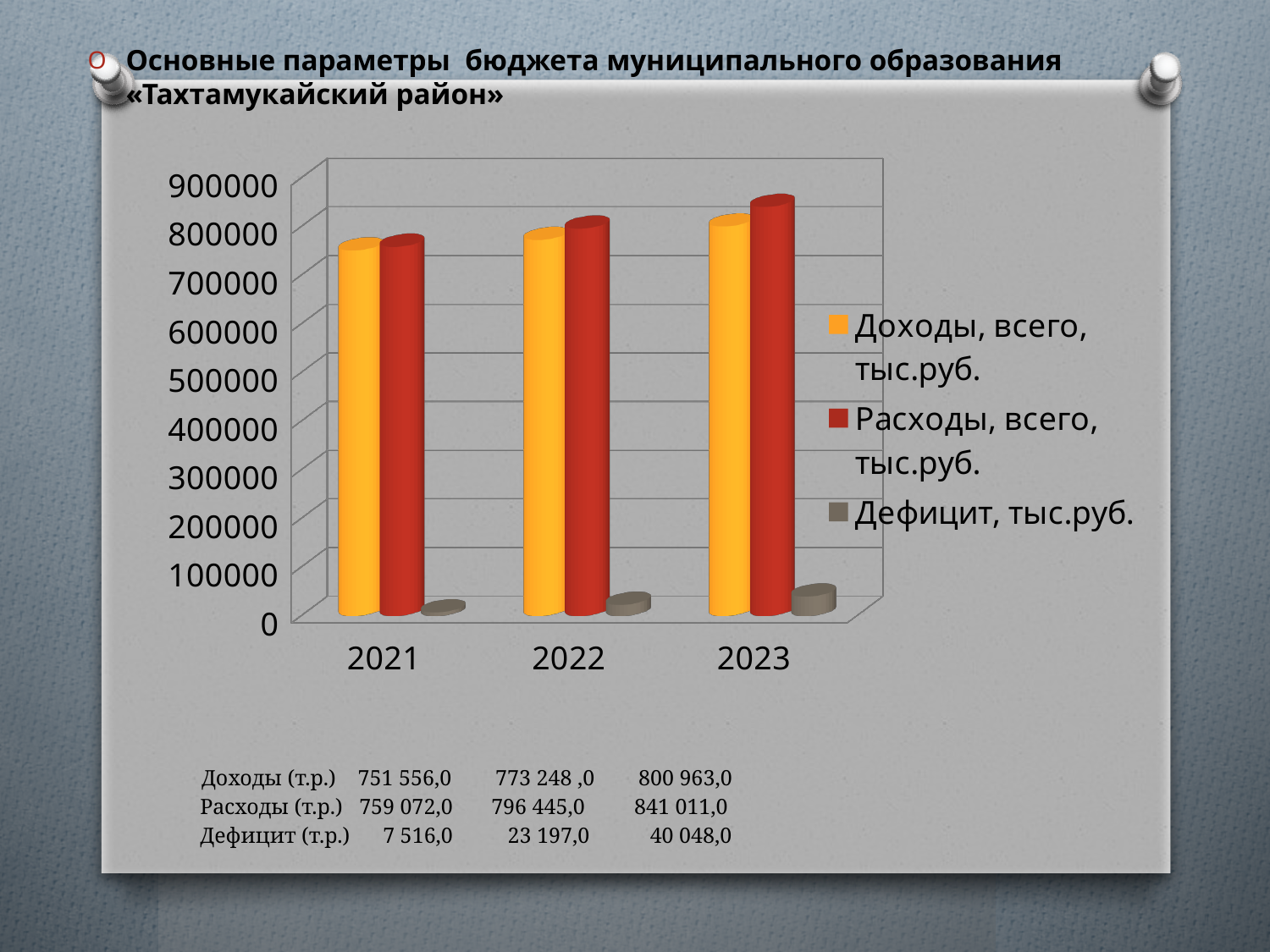
Is the Доходы, всего bar for 2023 greater or less than 700000? greater What kind of chart is shown on the slide? bar chart According to the figures printed below the chart, what is the value of Доходы (т.р.) for 2021? 751 556,0 Which colour represents Дефицит, тыс.руб. in the chart legend? grey According to the figures printed below the chart, what is the value of Расходы (т.р.) for 2023? 841 011,0 Is the Дефицит bar for 2023 greater or less than 100000? less How many years are shown on the x axis of the chart? 3 In which year is the Дефицит bar the lowest? 2021 How many series does the chart legend list? 3 Do the Расходы, всего values rise or fall from 2021 to 2023? rise According to the figures printed below the chart, what is the value of Дефицит (т.р.) for 2022? 23 197,0 In which year is the Расходы, всего bar the highest? 2023